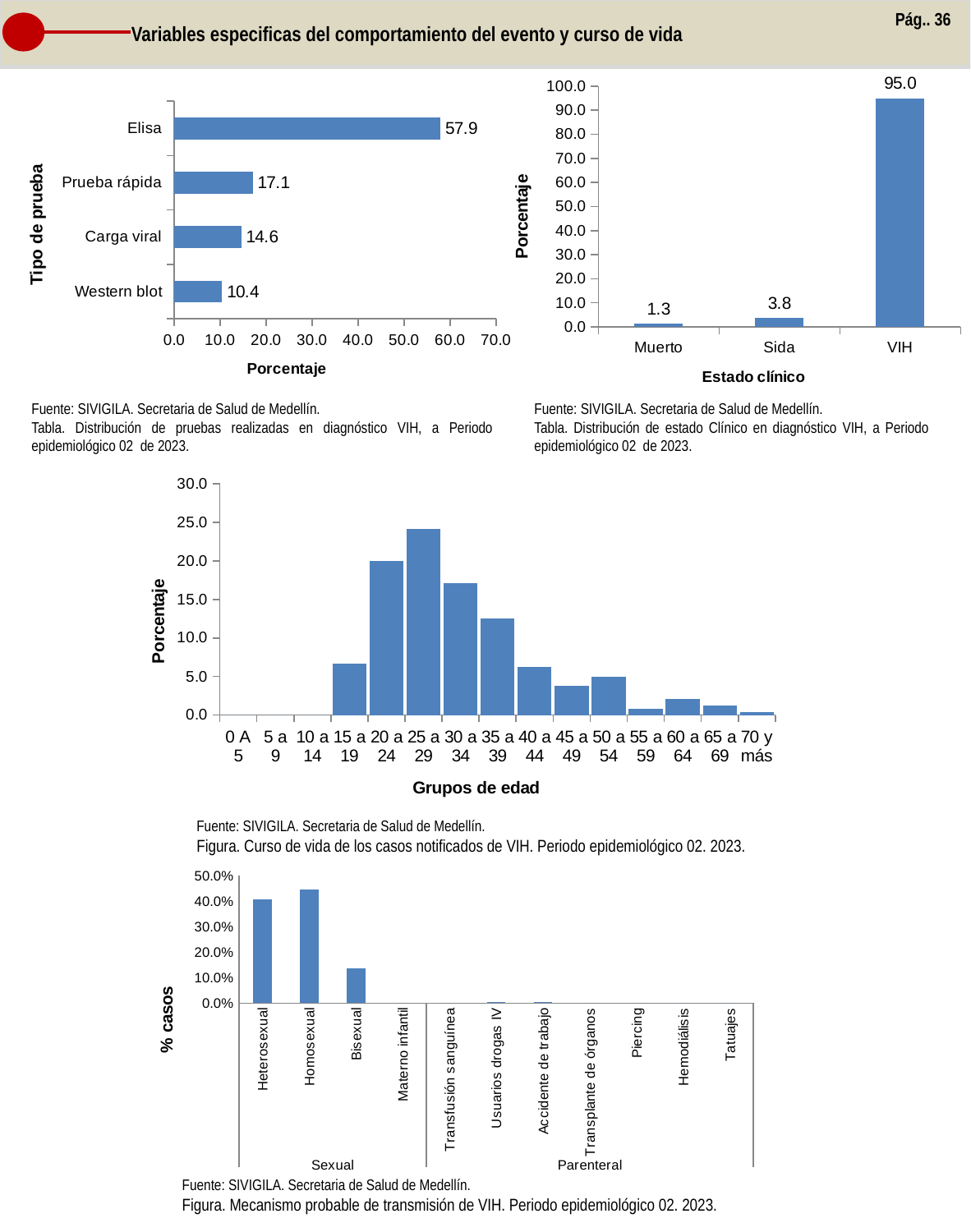
In the top-right chart (Estado clínico), which category has the lowest value? Muerto In the bottom chart (Mecanismo probable de transmisión), is the value for Bisexual greater or less than 20.0%? less In the bottom chart (Mecanismo probable de transmisión), which category has the highest value? Homosexual In the top-left chart (Tipo de prueba), what is the value for Western blot? 10.4 In the top-left chart (Tipo de prueba), how many test types are shown? 4 In the middle chart (Grupos de edad), which age group has the highest percentage? 25 a 29 In the middle chart (Grupos de edad), is the value for 30 a 34 greater or less than 15.0? greater In the top-right chart (Estado clínico), which category has the highest value? VIH In the middle chart (Grupos de edad), how many age groups are shown on the x axis? 15 In the top-right chart (Estado clínico), what is the value for Sida? 3.8 In the top-left chart (Tipo de prueba), what is the difference between Prueba rápida and Carga viral? 2.5 In the top-left chart (Tipo de prueba), what is the value for Elisa? 57.9